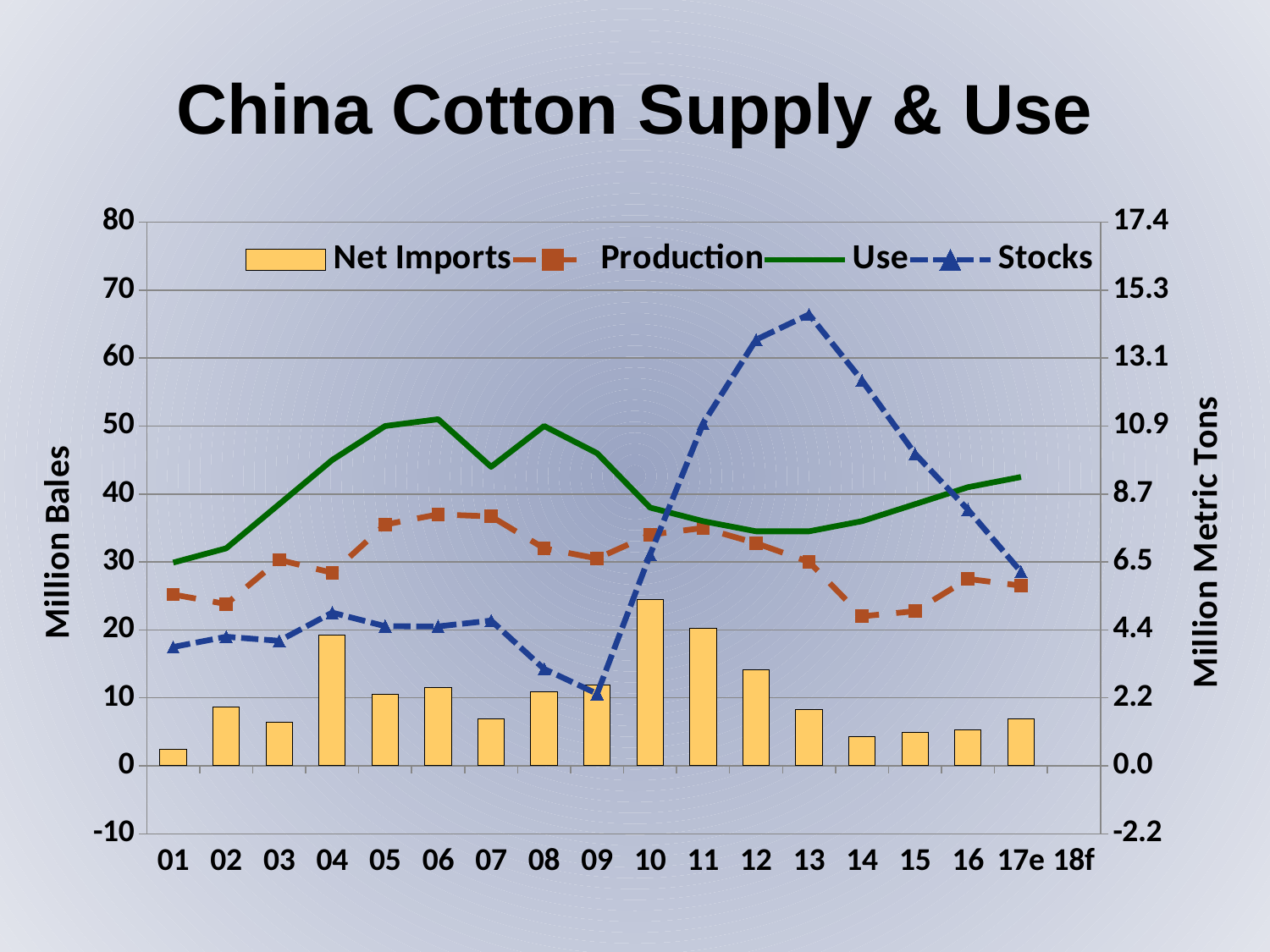
In which year does the Stocks line reach its highest point? 13 Which is larger in 05, Use or Production? Use Is the Net Imports value for 10 greater or less than 20 million bales? greater In which year is the Net Imports bar the shortest? 01 Is the Use value for 01 greater or less than 40 million bales? less Does the Stocks line rise or fall from 09 to 13? rise What kind of chart is this? Combination bar and line chart What is the label of the left vertical axis? Million Bales How many series does the legend list? 4 In which year does the Stocks line reach its lowest point? 09 In which year is the Net Imports bar the tallest? 10 What is the title of the chart? China Cotton Supply & Use